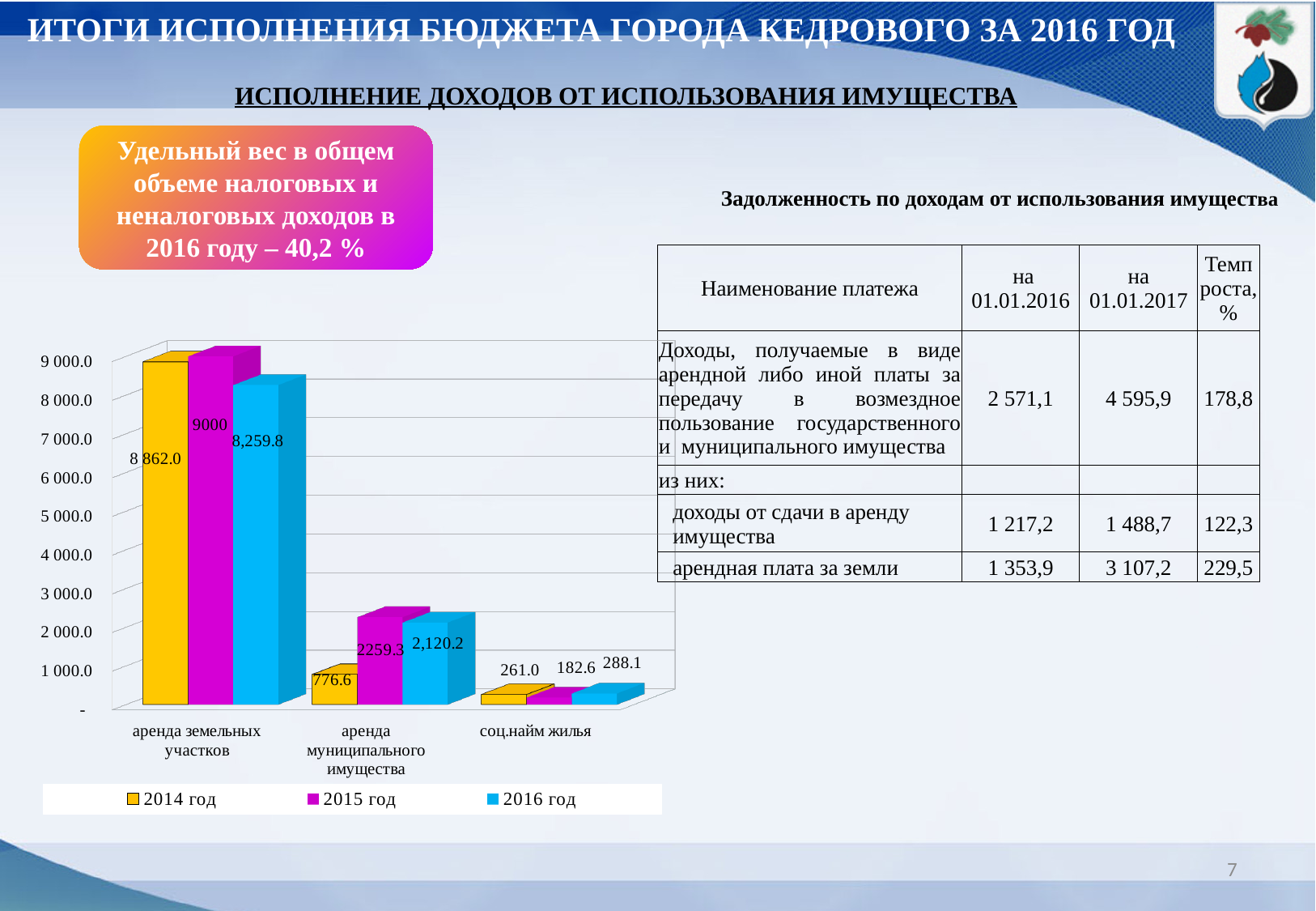
What is the difference between the 2015 год and 2014 год values for аренда земельных участков? 138.0 Which category has the lowest value in 2014 год? соц.найм жилья Which category has the highest value in 2015 год? аренда земельных участков What is the difference between the 2014 год and 2015 год values for соц.найм жилья? 78.4 What is the value for аренда земельных участков in 2016 год? 8,259.8 How many series does the chart legend list? 3 What is the value for аренда земельных участков in 2014 год? 8 862.0 How many categories are shown on the x axis of the chart? 3 What is the value for соц.найм жилья in 2016 год? 288.1 Which is larger for аренда муниципального имущества: the 2015 год value or the 2016 год value? 2015 год What kind of chart is shown on the slide? bar chart What is the value for аренда муниципального имущества in 2015 год? 2259.3